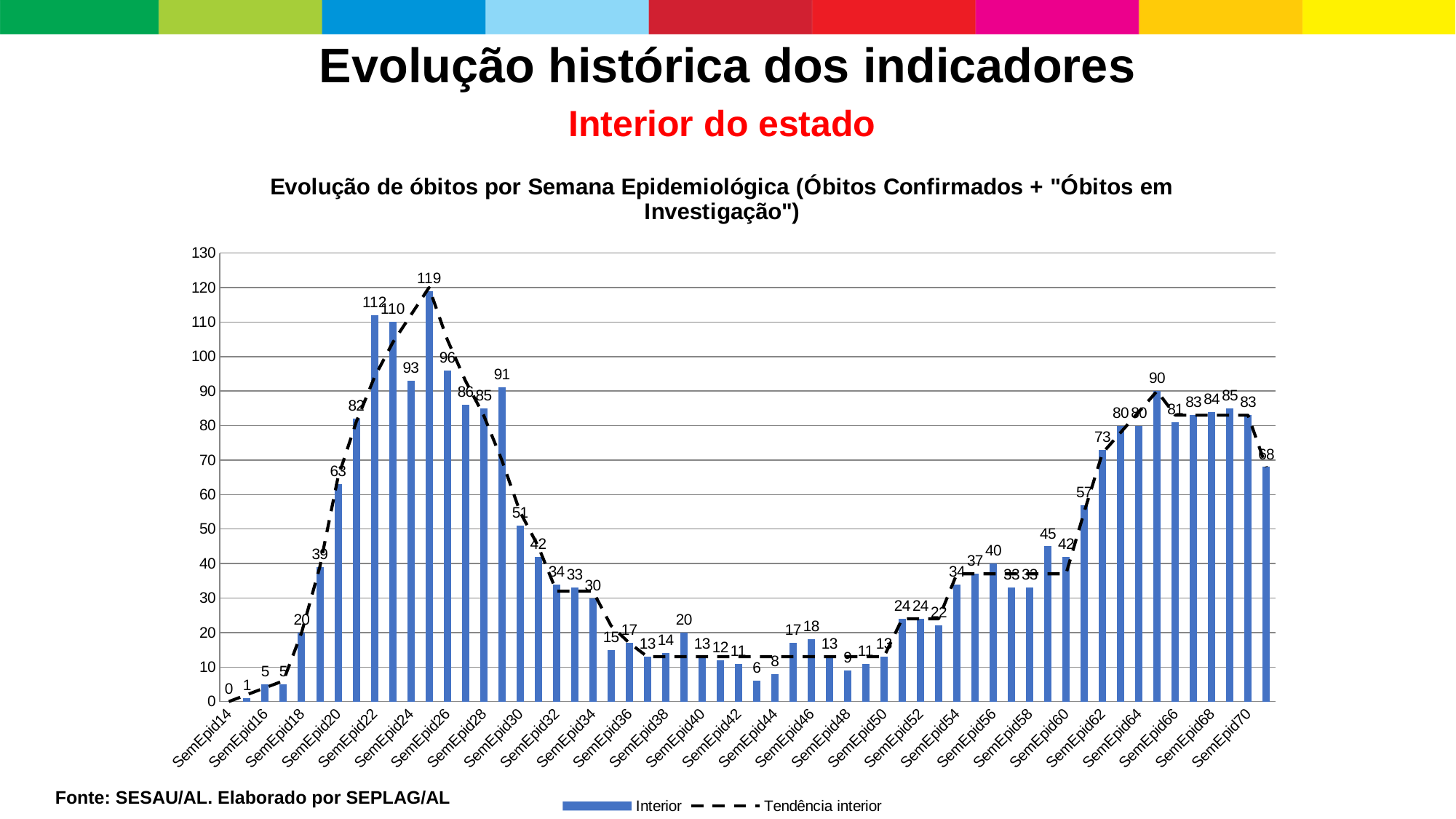
What is the value for SemEpid70? 83 Is the value for SemEpid26 greater or less than 90? greater Do the values rise or fall from SemEpid14 to SemEpid22? rise What is the value for SemEpid62? 73 What is the highest value shown on the chart? 119 What is the value for SemEpid20? 63 What is the value for SemEpid22? 112 How many series does the legend list? 2 Which labeled week has the lowest value on the chart? SemEpid14 What is the difference between the values for SemEpid22 and SemEpid20? 49 What kind of chart is shown on the slide? combination bar and line chart Which is larger, the value for SemEpid62 or the value for SemEpid30? SemEpid62